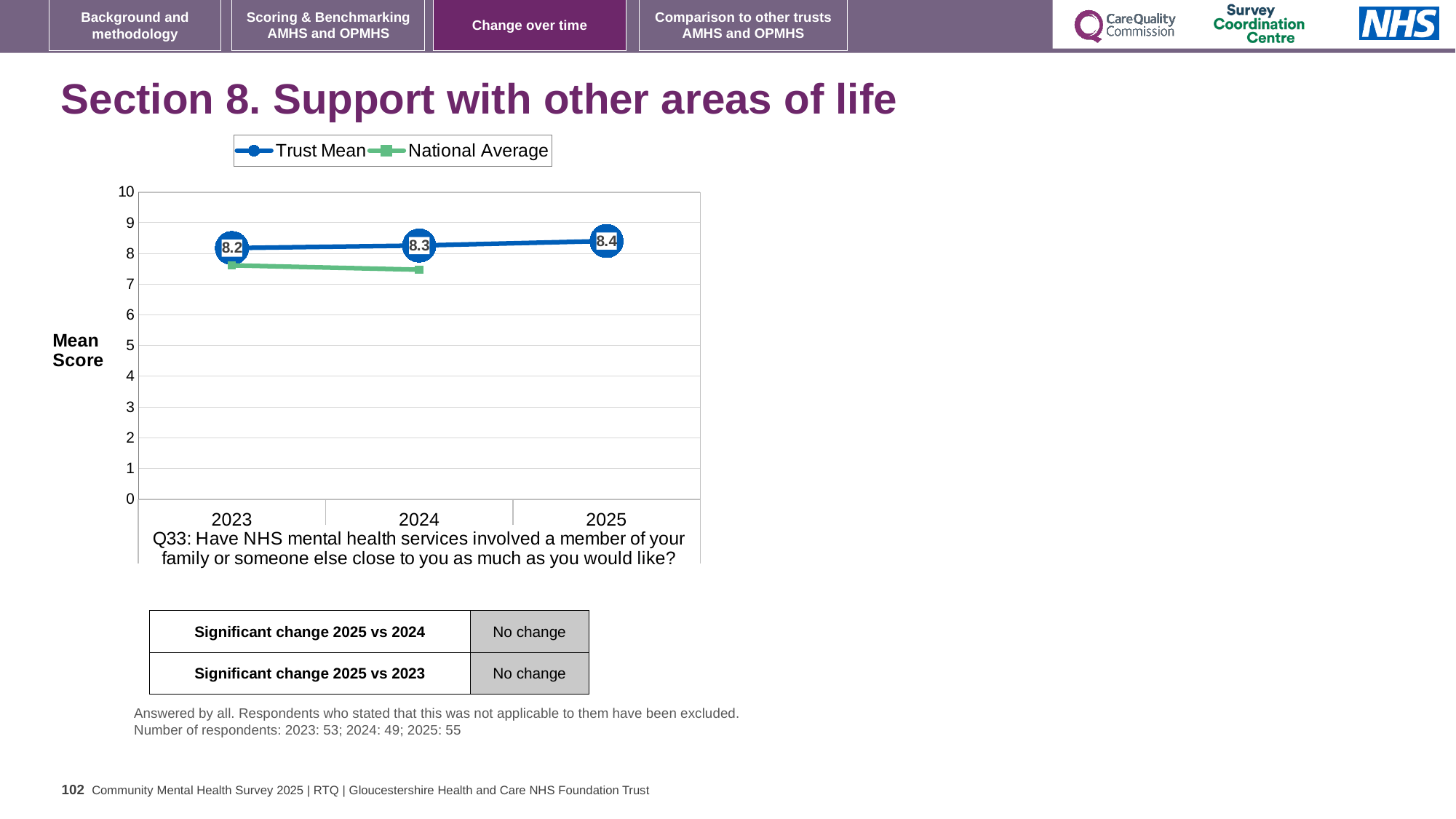
What is the Trust Mean value for 2024? 8.3 What is the Trust Mean value for 2023? 8.2 How many series does the chart legend list? 2 In 2024, which is larger: the Trust Mean or the National Average? Trust Mean In which year is the Trust Mean highest? 2025 Is the National Average value for 2024 greater or less than 7? greater What is the difference between the Trust Mean in 2025 and in 2023? 0.2 In which year is the Trust Mean lowest? 2023 What kind of chart is shown on the slide? Line chart How many years are shown on the x axis of the chart? 3 Is the National Average value for 2023 greater or less than 8? less What is the Trust Mean value for 2025? 8.4